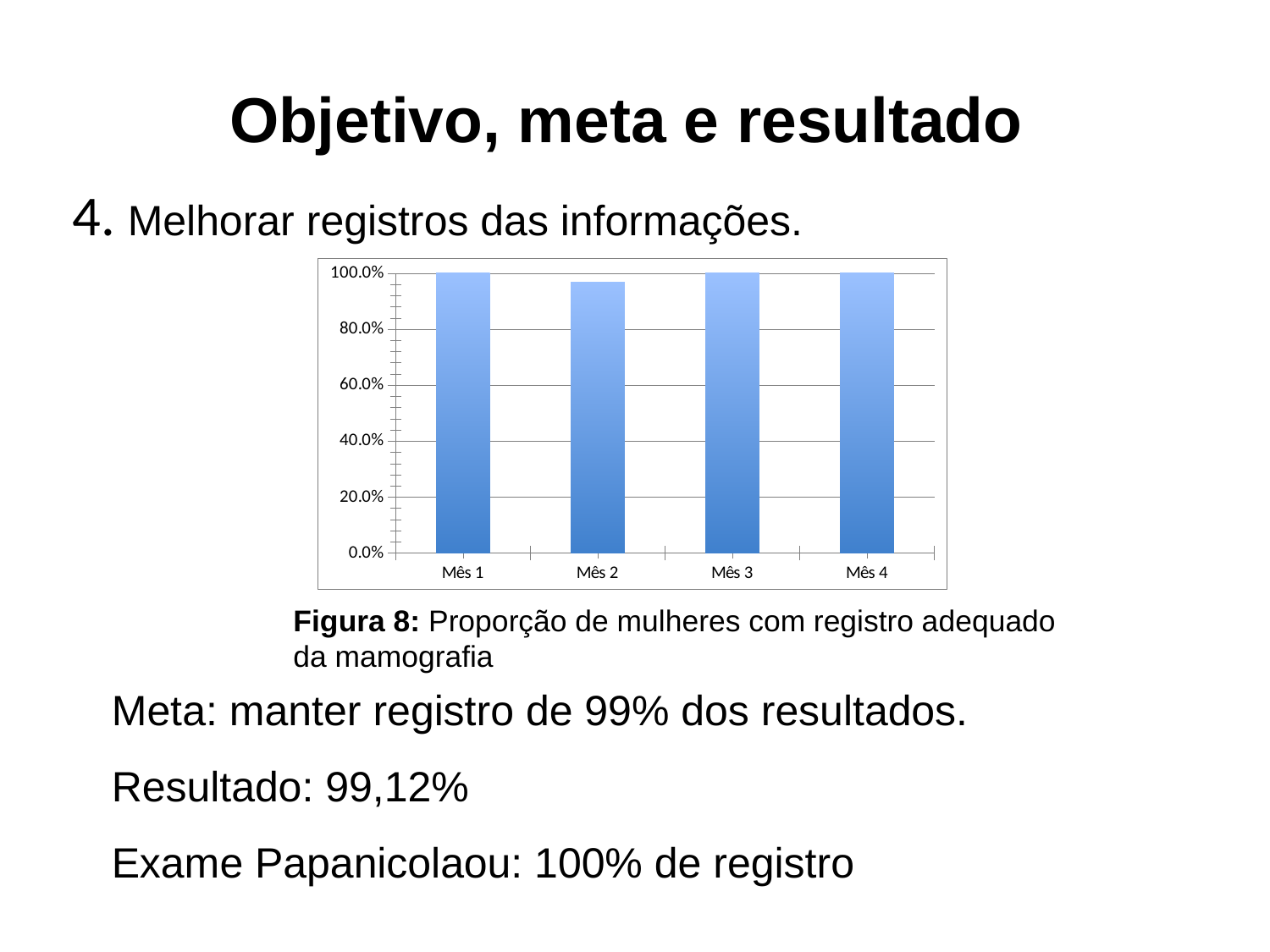
Is the value for Mês 2 greater or less than 80.0%? greater How many categories (months) are shown on the x axis of the chart? 4 What value does the bar for Mês 1 reach on the y axis? 100.0% Which is larger, the value for Mês 2 or the value for Mês 3? Mês 3 Is the value for Mês 2 greater or less than 100.0%? less What is the highest tick value shown on the y axis of the chart? 100.0% Which month has the lowest bar in the chart? Mês 2 What kind of chart is shown on the slide? bar chart What is the figure number given in the caption below the chart? Figura 8 Which is larger, the value for Mês 1 or the value for Mês 2? Mês 1 What value does the bar for Mês 4 reach on the y axis? 100.0%